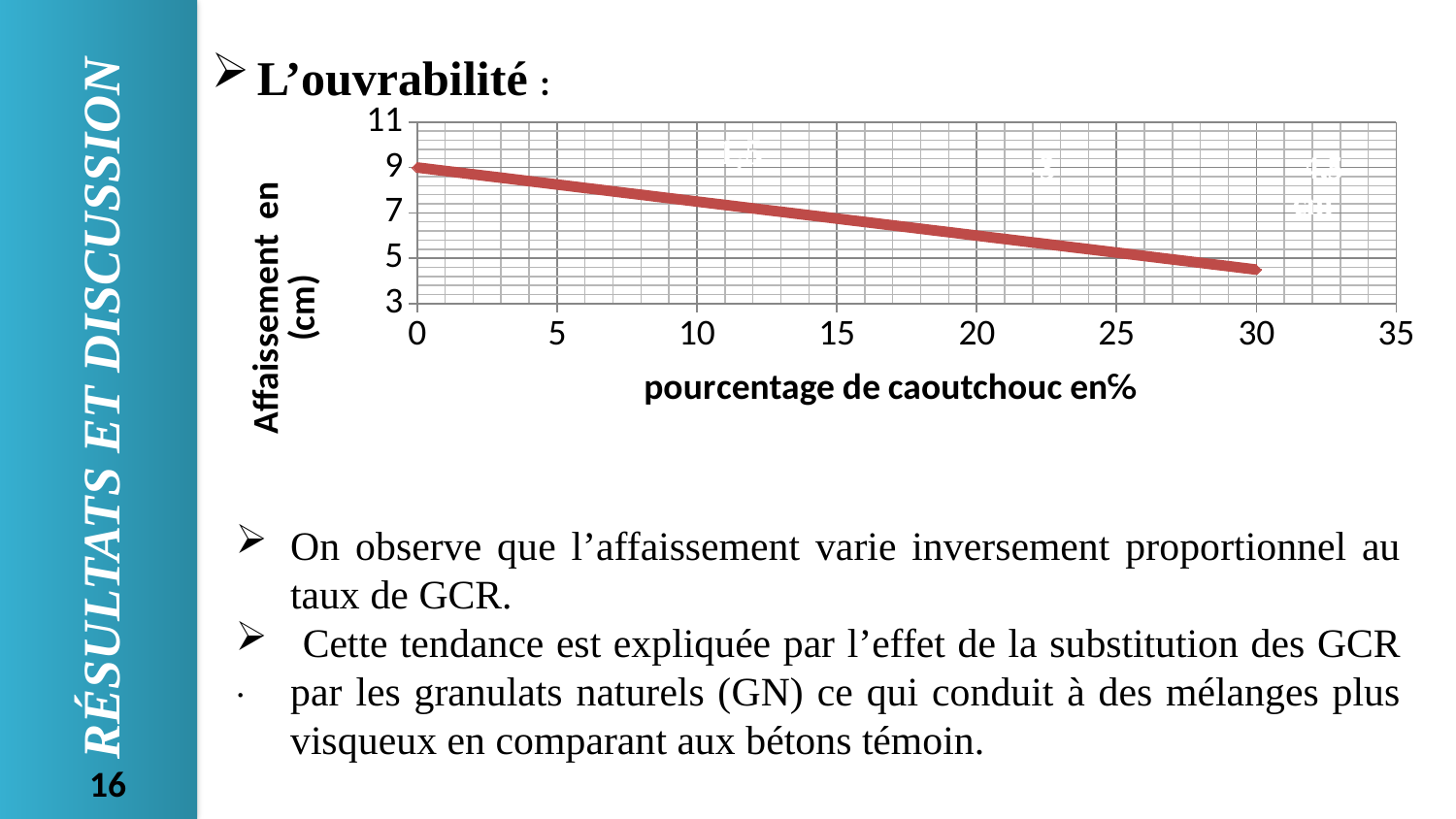
What kind of chart is shown on the slide? line chart Which has the higher affaissement: 0% caoutchouc or 30% caoutchouc? 0% caoutchouc Is the affaissement value at 30% caoutchouc greater or less than 5? less At which pourcentage de caoutchouc shown is the affaissement highest? 0 At which pourcentage de caoutchouc shown is the affaissement lowest? 30 Is the affaissement value at 20% caoutchouc greater or less than 5? greater Is the affaissement value at 10% caoutchouc greater or less than 9? less Does the affaissement rise or fall as the pourcentage de caoutchouc increases? fall What is the title of the x axis of the chart? pourcentage de caoutchouc en% What is the title of the y axis of the chart? Affaissement en (cm)